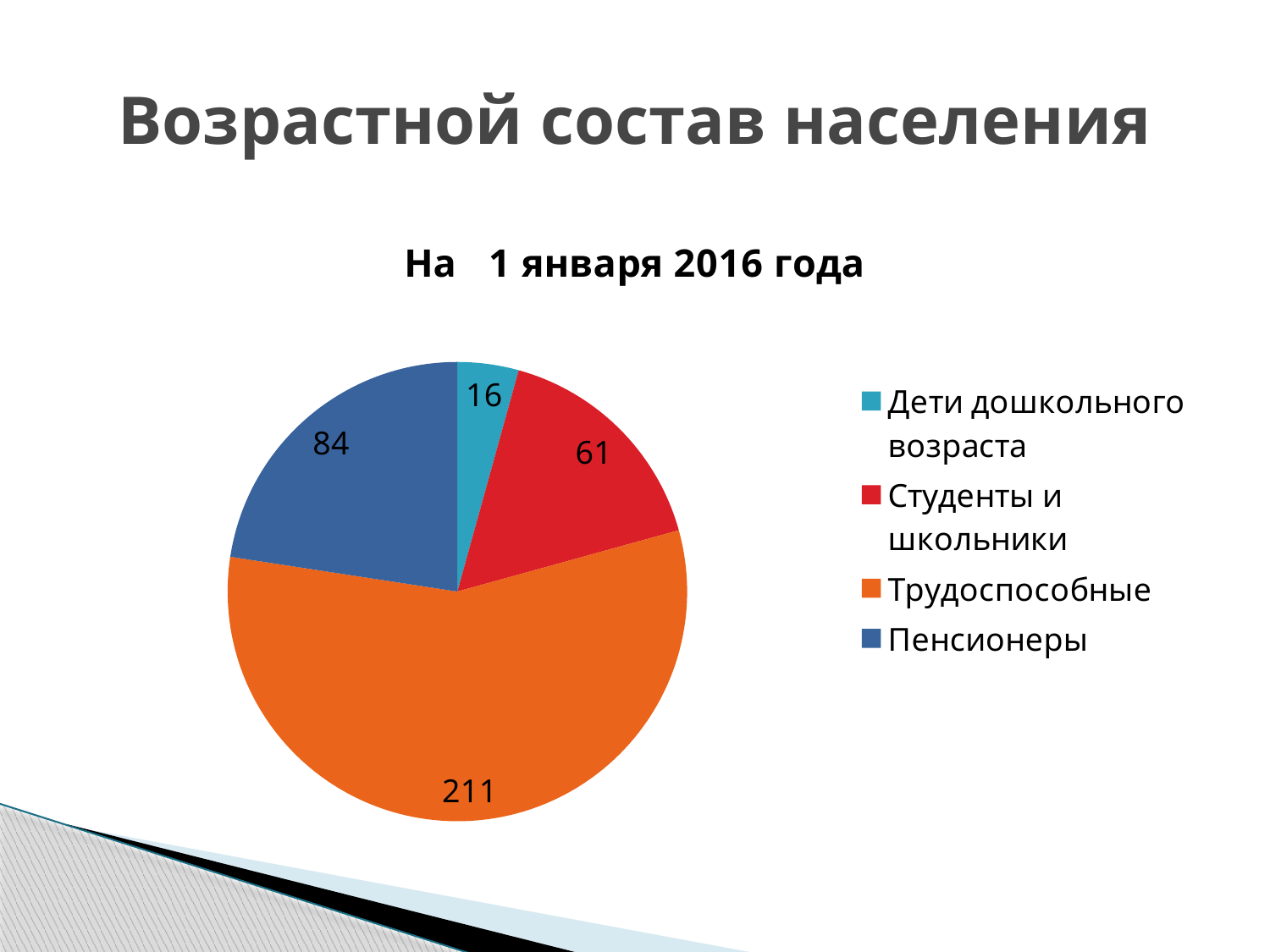
Which category has the largest slice of the pie? Трудоспособные How many categories does the pie chart have? 4 What is the title shown above the pie chart? На 1 января 2016 года What is the total of all slices in the pie chart? 372 Which category has the smallest slice of the pie? Дети дошкольного возраста What is the value for Студенты и школьники? 61 What is the difference between the values for Пенсионеры and Студенты и школьники? 23 What is the value for Трудоспособные? 211 What is the value for Пенсионеры? 84 What kind of chart is shown on the slide? pie chart What is the value for Дети дошкольного возраста? 16 Which is larger, the value for Пенсионеры or the value for Студенты и школьники? Пенсионеры